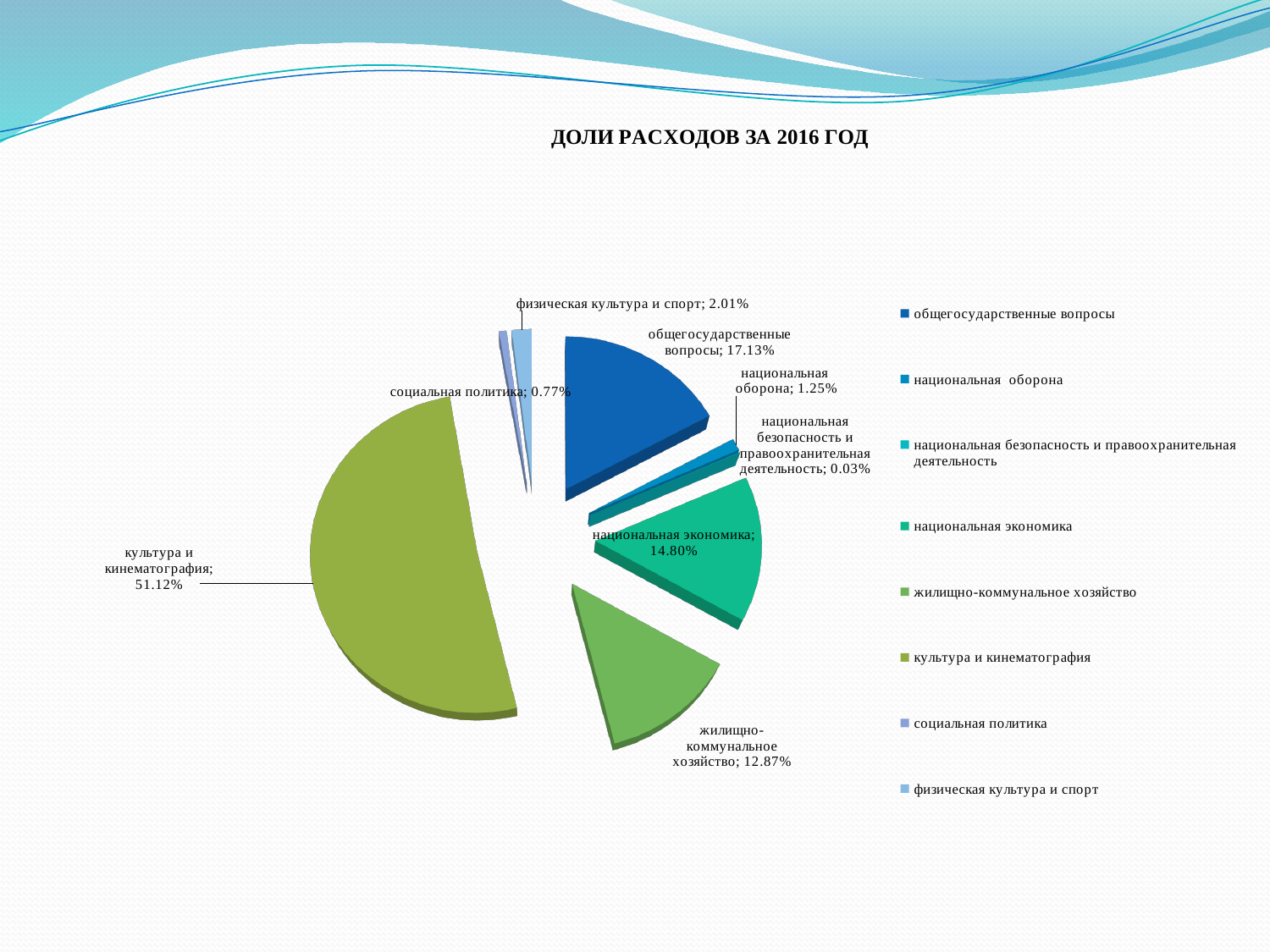
What is the value for жилищно-коммунальное хозяйство? 12.87% What share of expenditures is shown for культура и кинематография? 51.12% Which category has the largest share of the pie? культура и кинематография What is the difference between the shares of общегосударственные вопросы and национальная экономика? 2.33% What is the title of the chart? ДОЛИ РАСХОДОВ ЗА 2016 ГОД How many categories does the legend list? 8 What type of chart is shown on the slide? Pie chart Which category has the smallest share of the pie? национальная безопасность и правоохранительная деятельность What is the value shown for общегосударственные вопросы? 17.13% What share is shown for национальная безопасность и правоохранительная деятельность? 0.03% Which is larger: the share for физическая культура и спорт or the share for национальная оборона? физическая культура и спорт What percentage is shown for национальная экономика? 14.80%